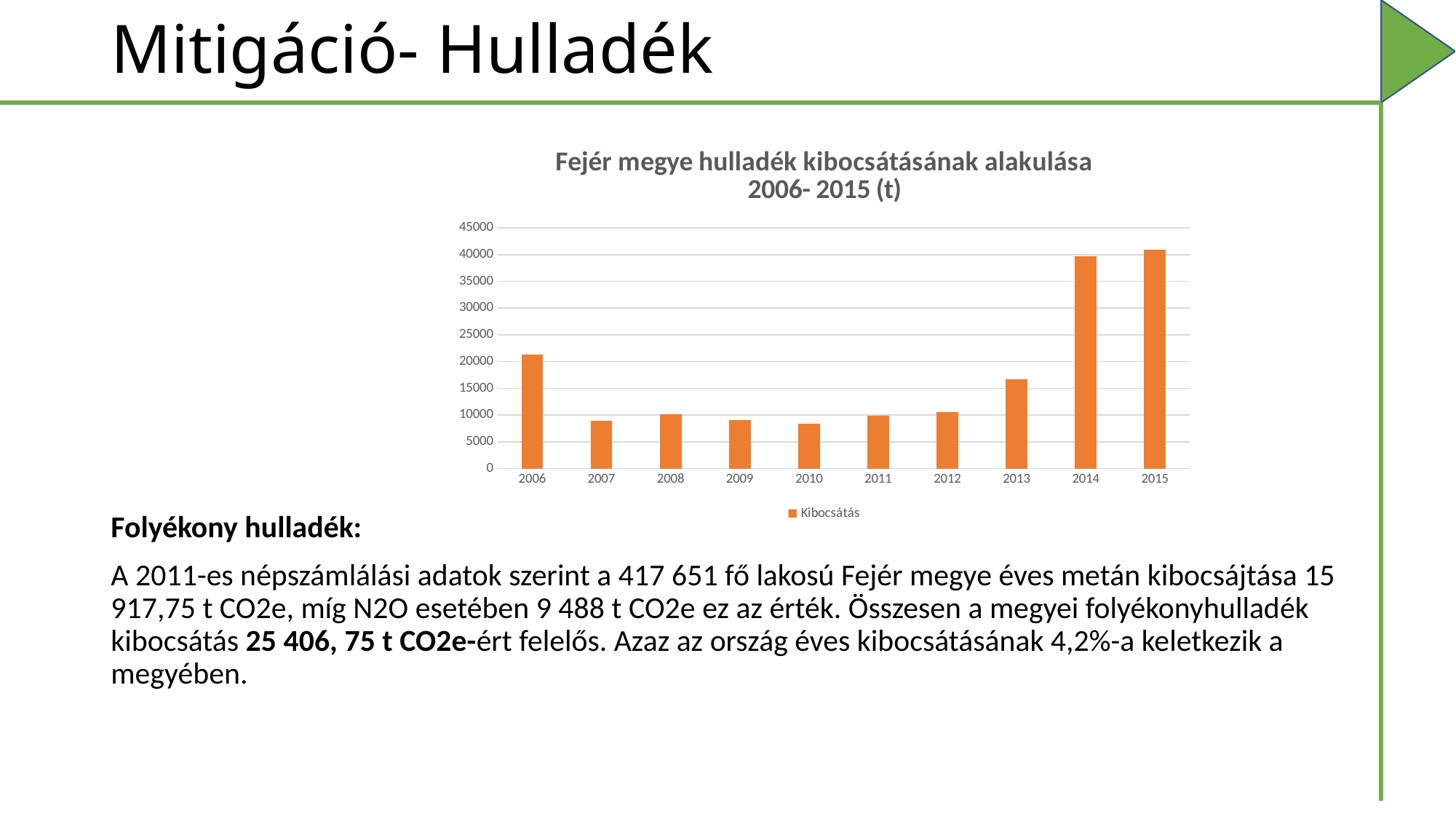
Which year has the larger value, 2006 or 2013? 2006 What is the name of the series shown in the chart's legend? Kibocsátás What is the title of the chart? Fejér megye hulladék kibocsátásának alakulása 2006- 2015 (t) How many series does the chart's legend list? 1 Is the value for 2010 greater or less than 10000? less Do the values rise or fall from 2010 to 2015? rise What kind of chart is shown on the slide? bar chart Is the value for 2006 greater or less than 20000? greater Is the value for 2013 greater or less than 15000? greater Which year has the larger value, 2012 or 2014? 2014 How many years (categories) are plotted on the x axis of the chart? 10